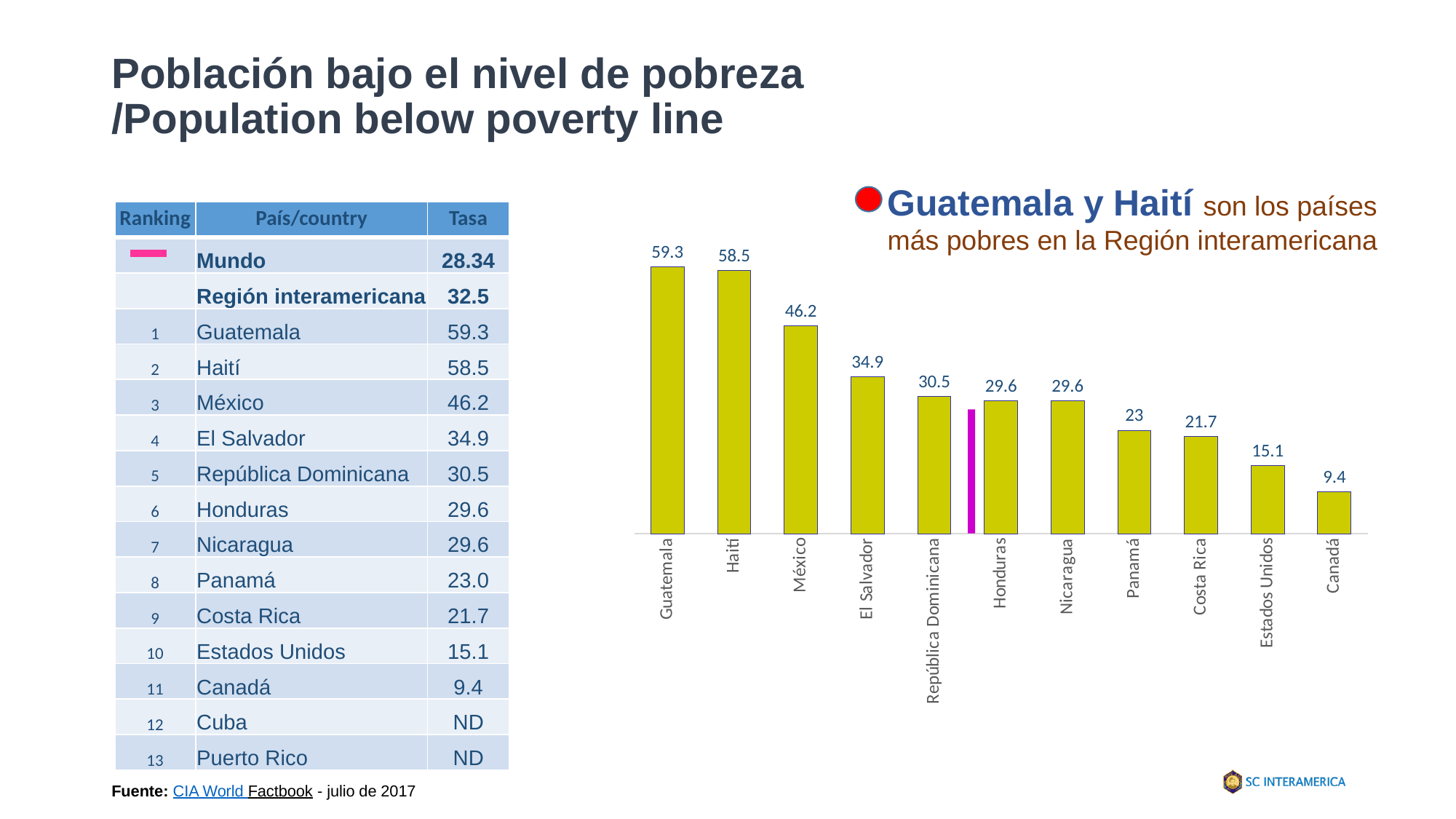
What is the value shown for Estados Unidos in the chart? 15.1 What kind of chart is shown on the slide? bar chart What is the value shown for México in the chart? 46.2 Which country has the lowest value in the chart? Canadá Which country has the highest value in the chart? Guatemala What is the difference between the values for Guatemala and Haití? 0.8 What is the difference between the values for México and El Salvador? 11.3 What is the value shown for Panamá in the chart? 23 What is the value shown for El Salvador in the chart? 34.9 Which has a larger value, República Dominicana or Honduras? República Dominicana Do the values in the chart rise or fall from left to right along the x axis? fall How many countries are labeled on the x axis of the chart? 11